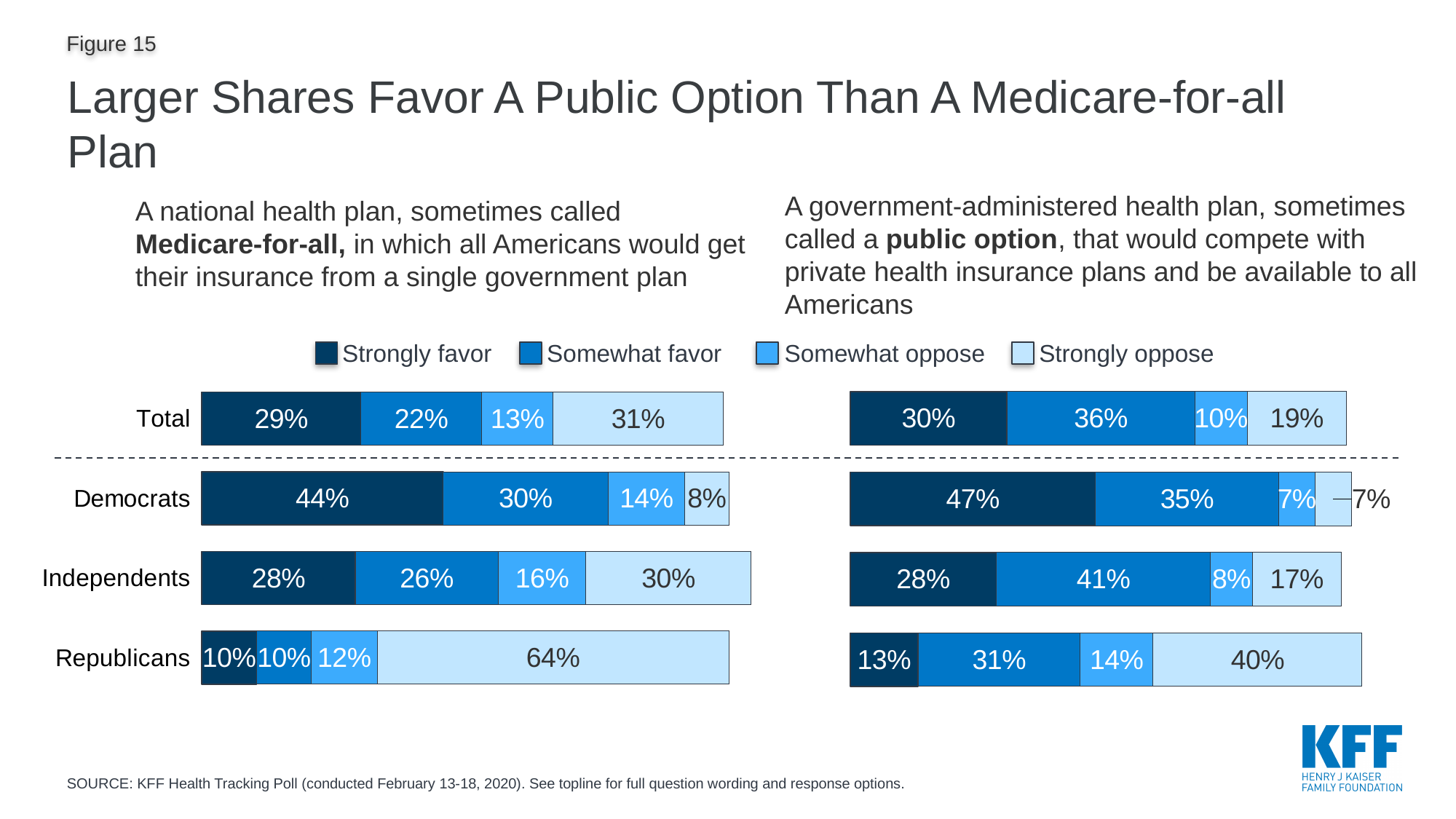
In the public option chart, what is the combined share of Democrats who strongly favor or somewhat favor the plan? 82% What kind of chart is used on this slide? Stacked bar chart In the Medicare-for-all chart, what is the difference between the strongly favor shares of Democrats and Republicans? 34 percentage points In the public option chart, what share of the Total strongly favor the plan? 30% In the public option chart, what share of Independents somewhat favor the plan? 41% In the Medicare-for-all chart, which group has the highest share strongly favoring the plan? Democrats How many groups are shown on the y axis of the Medicare-for-all chart? 4 Is the strongly oppose share for Republicans larger in the Medicare-for-all chart or the public option chart? Medicare-for-all chart Which legend entry is shown in the darkest blue? Strongly favor In the Medicare-for-all chart, what share of Republicans strongly oppose the plan? 64% How many series does the legend list? 4 In the public option chart, which group has the lowest share strongly favoring the plan? Republicans